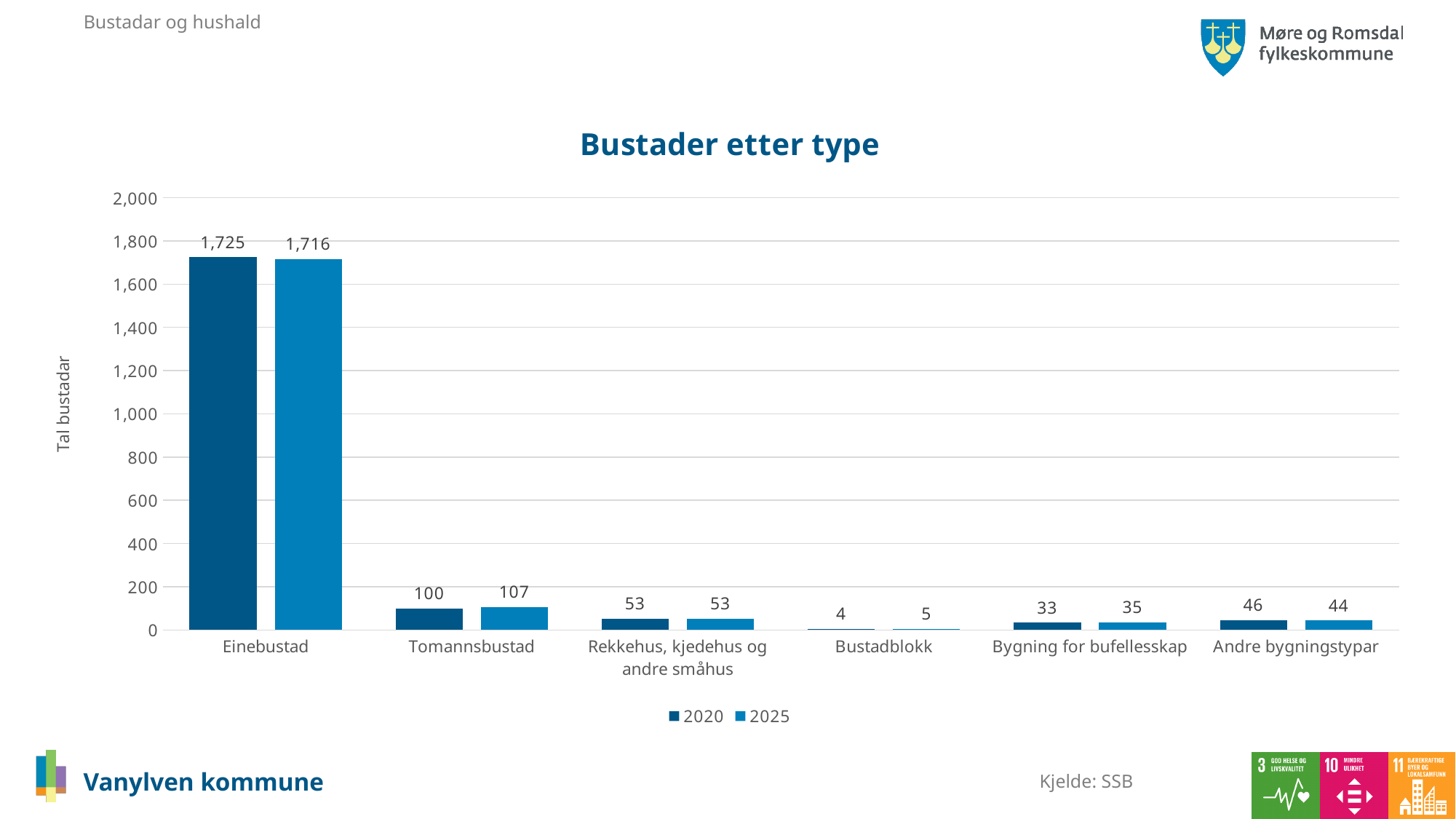
What is the title of the chart? Bustader etter type What is the value for Bustadblokk in 2020? 4 What is the difference between the 2020 and 2025 values for Einebustad? 9 Which category has the highest value in 2025? Einebustad What is the value for Einebustad in 2020? 1,725 What kind of chart is shown? Bar chart Which is larger for Bygning for bufellesskap: the 2020 value or the 2025 value? 2025 How many categories are shown on the x axis? 6 What is the value for Andre bygningstypar in 2025? 44 How many series does the legend list? 2 What is the value for Tomannsbustad in 2025? 107 Which category has the lowest value in 2020? Bustadblokk